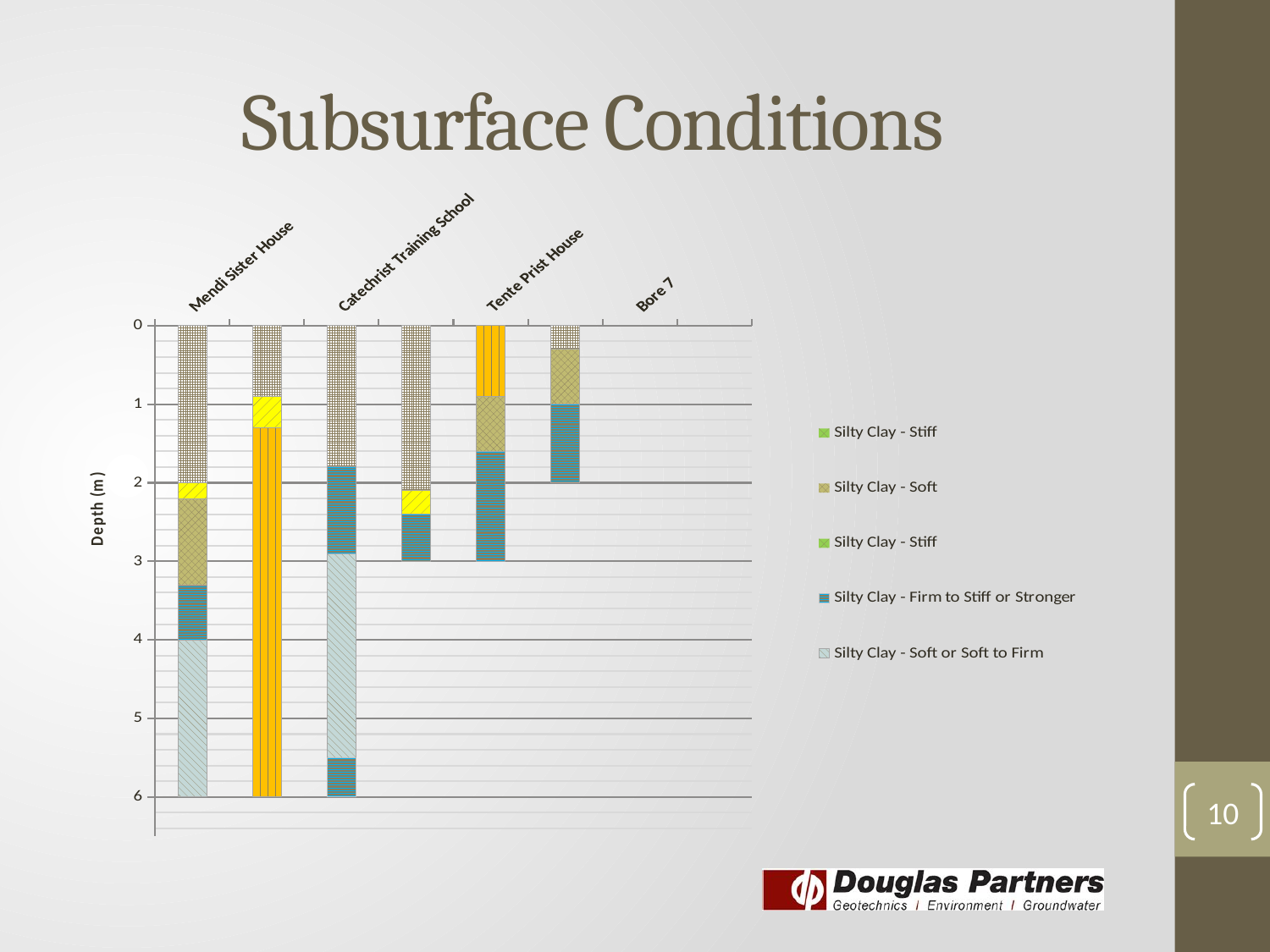
How many bars are plotted in the chart? 6 At what depth does the rightmost bar in the chart end? 2 Is the depth reached by the leftmost bar greater or less than 5? greater What is the label on the vertical axis of the chart? Depth (m) At what depth does the fourth bar from the left end? 3 What is the largest depth value shown on the vertical axis? 6 What is the title of the slide's chart? Subsurface Conditions How many entries does the chart's legend list? 5 Which reaches a greater depth, the leftmost bar or the rightmost bar? The leftmost bar Which bar reaches the shallowest depth? The rightmost bar Is the depth reached by the rightmost bar greater or less than 3? less What kind of chart is shown on the slide? Stacked bar chart